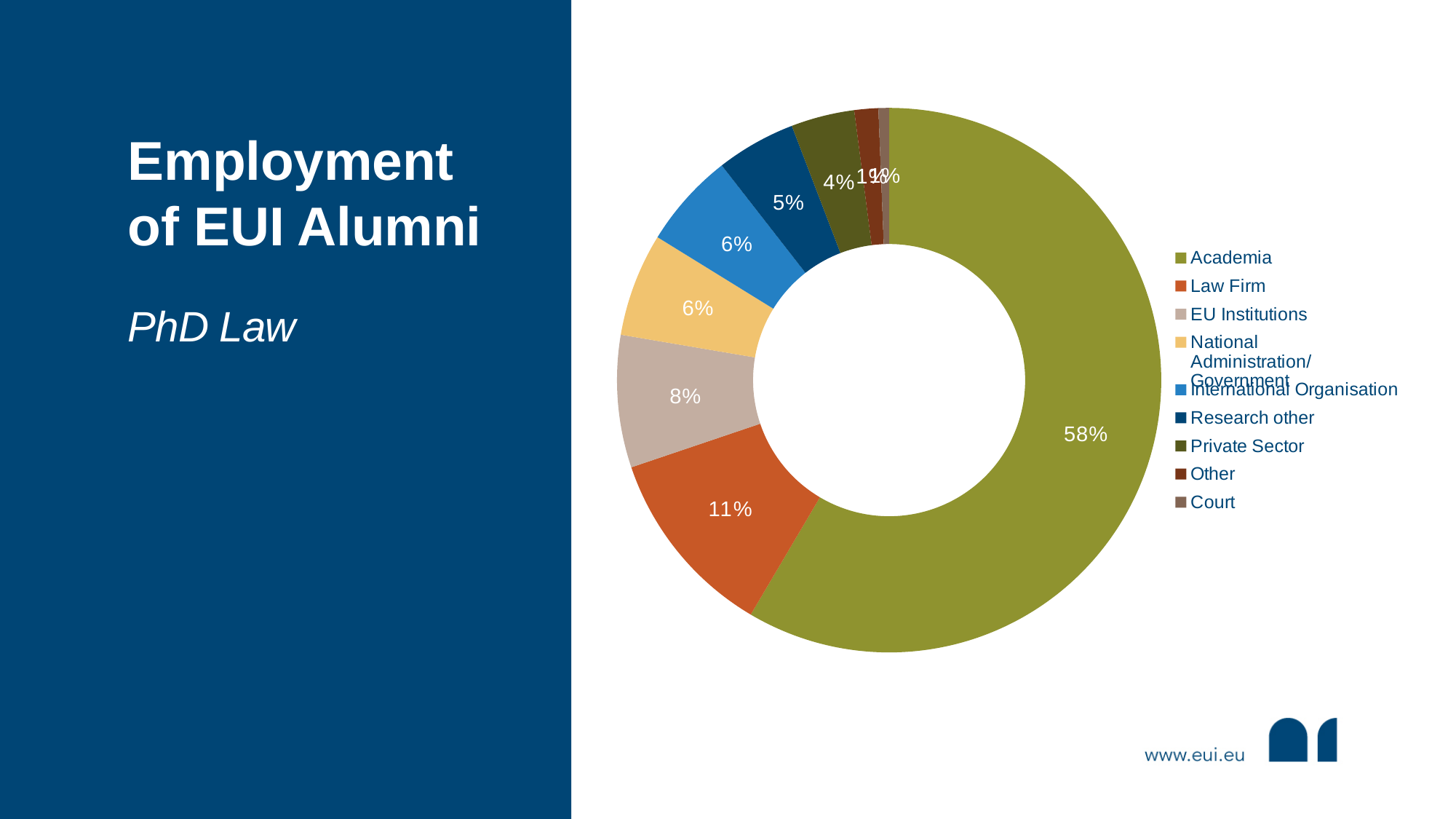
Which PhD programme does the slide's chart refer to? PhD Law What percentage of alumni work in a Law Firm? 11% Which employment category has the largest share? Academia How many percentage points larger is the Academia share than the Law Firm share? 47 percentage points What kind of chart is shown on the slide? doughnut (pie) chart What percentage of alumni work in the Private Sector? 4% What share of EUI PhD Law alumni are employed in Academia? 58% What percentage of alumni work in an International Organisation? 6% What percentage of alumni work in EU Institutions? 8% Which is larger, the share for EU Institutions or the share for Research other? EU Institutions How many employment categories does the legend list? 9 What percentage of alumni are in the Research other category? 5%